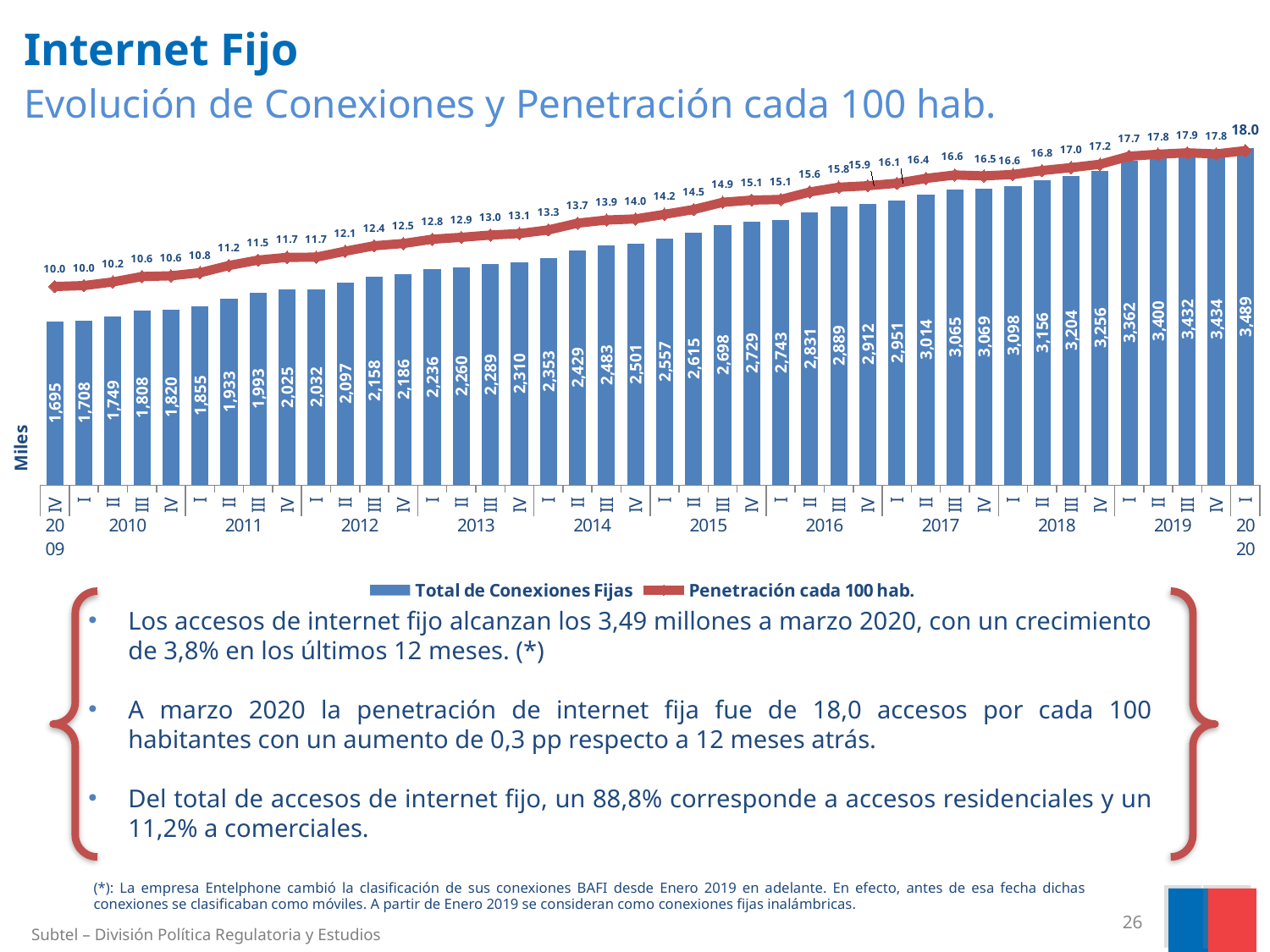
How many quarters are plotted on the chart? 42 What kind of chart is shown on the slide? Combined bar and line chart Which is larger, the Total de Conexiones Fijas in quarter IV of 2016 or in quarter I of 2017? I 2017 What is the value of Total de Conexiones Fijas for quarter I of 2020? 3,489 Which quarter has the highest Total de Conexiones Fijas? I 2020 What is the Penetración cada 100 hab. value for quarter II of 2014? 13.7 Which quarter has the lowest Total de Conexiones Fijas? IV 2009 What is the value of Total de Conexiones Fijas for quarter IV of 2009? 1,695 What is the Penetración cada 100 hab. value for quarter I of 2020? 18.0 How many series does the legend list? 2 Does the Total de Conexiones Fijas generally rise or fall from IV 2009 to I 2020? Rise What is the difference in Total de Conexiones Fijas between quarter I of 2020 and quarter I of 2019? 127